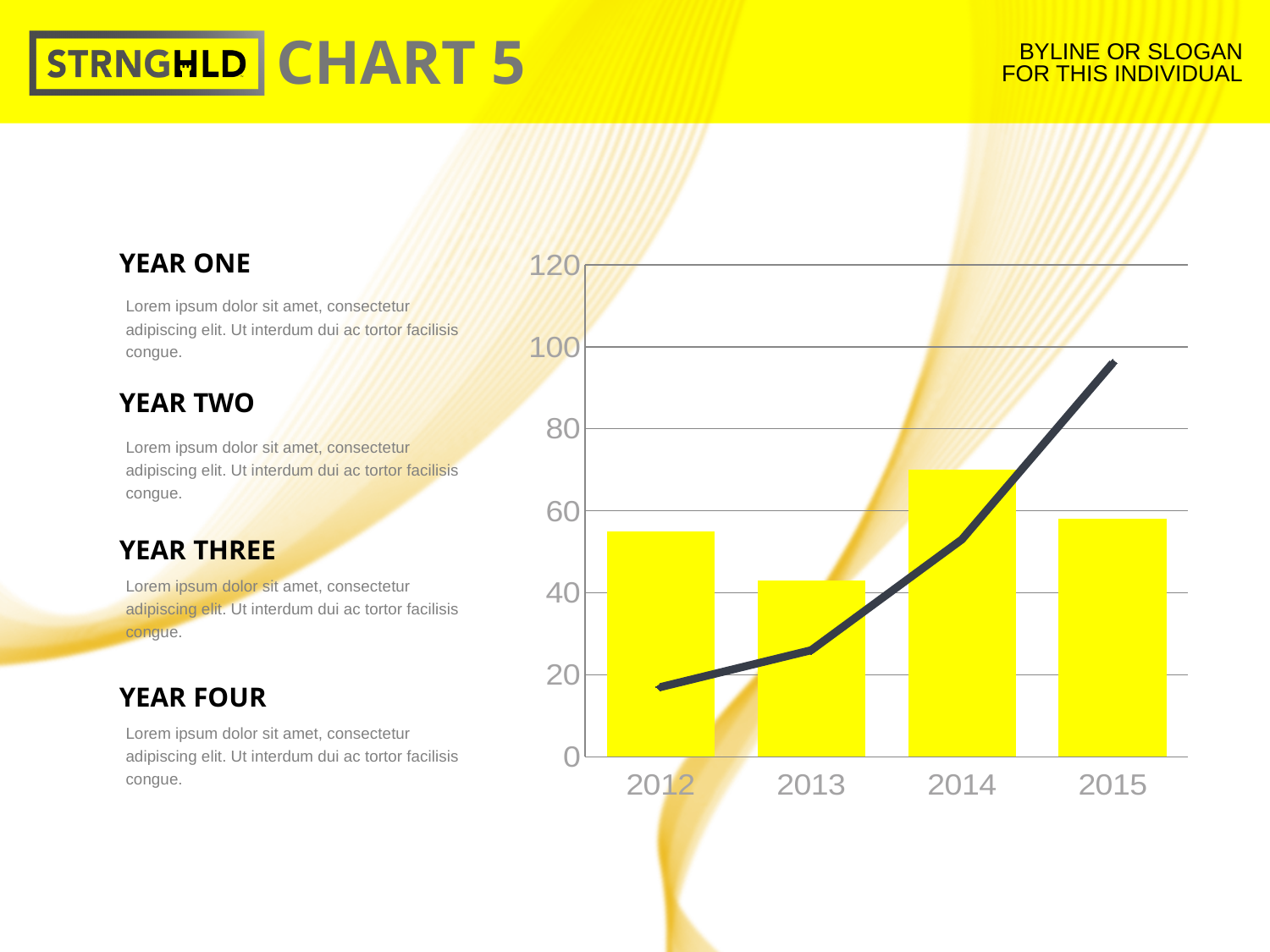
Is the bar value for 2014 greater or less than 60? greater Is the bar value for 2013 greater or less than 60? less What kind of chart is shown on the slide? A bar chart with a line overlaid Is the bar for 2015 taller or shorter than the bar for 2014? shorter Which year has the shortest bar? 2013 How many years are shown on the x axis of the chart? 4 Does the line rise or fall from 2012 to 2015? rises Is the line value for 2012 greater or less than 40? less Is the bar for 2012 taller or shorter than the bar for 2013? taller Which year has the tallest bar? 2014